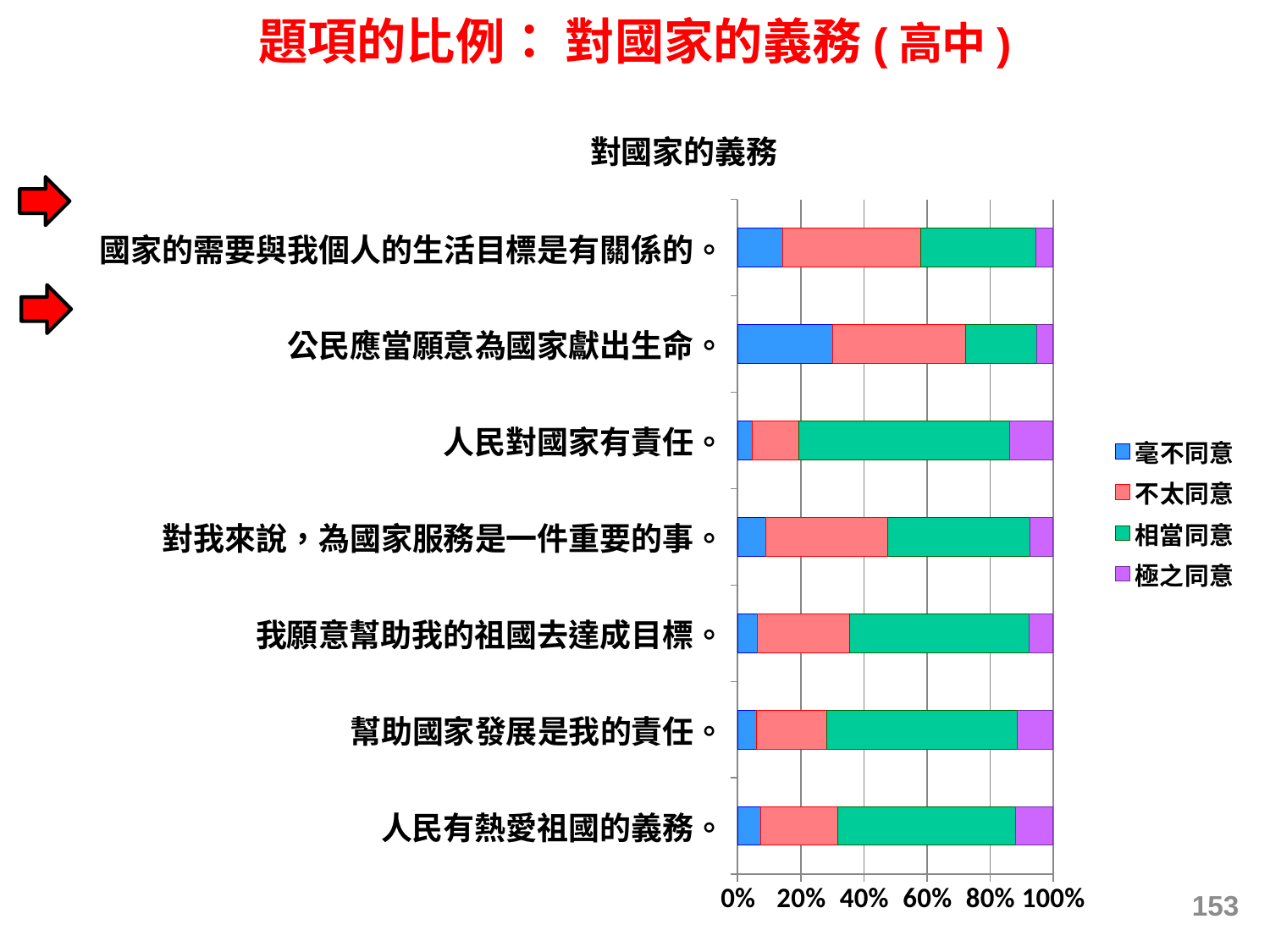
Which has the larger 毫不同意 share: 公民應當願意為國家獻出生命 or 國家的需要與我個人的生活目標是有關係的? 公民應當願意為國家獻出生命。 Which statement has the largest 毫不同意 share? 公民應當願意為國家獻出生命。 How many series does the legend list? 4 Is the combined 毫不同意 and 不太同意 share for 公民應當願意為國家獻出生命 greater or less than 60%? greater Is the 極之同意 share for 公民應當願意為國家獻出生命 greater or less than 20%? less What is the title of the chart? 對國家的義務 Is the 毫不同意 share for 公民應當願意為國家獻出生命 greater or less than 20%? greater How many statements (categories) are plotted in the chart? 7 What kind of chart is shown on the slide? Stacked bar chart Which legend entry is shown in green? 相當同意 Which statement has the largest 相當同意 share? 人民對國家有責任。 Which has the larger 相當同意 share: 人民對國家有責任 or 公民應當願意為國家獻出生命? 人民對國家有責任。